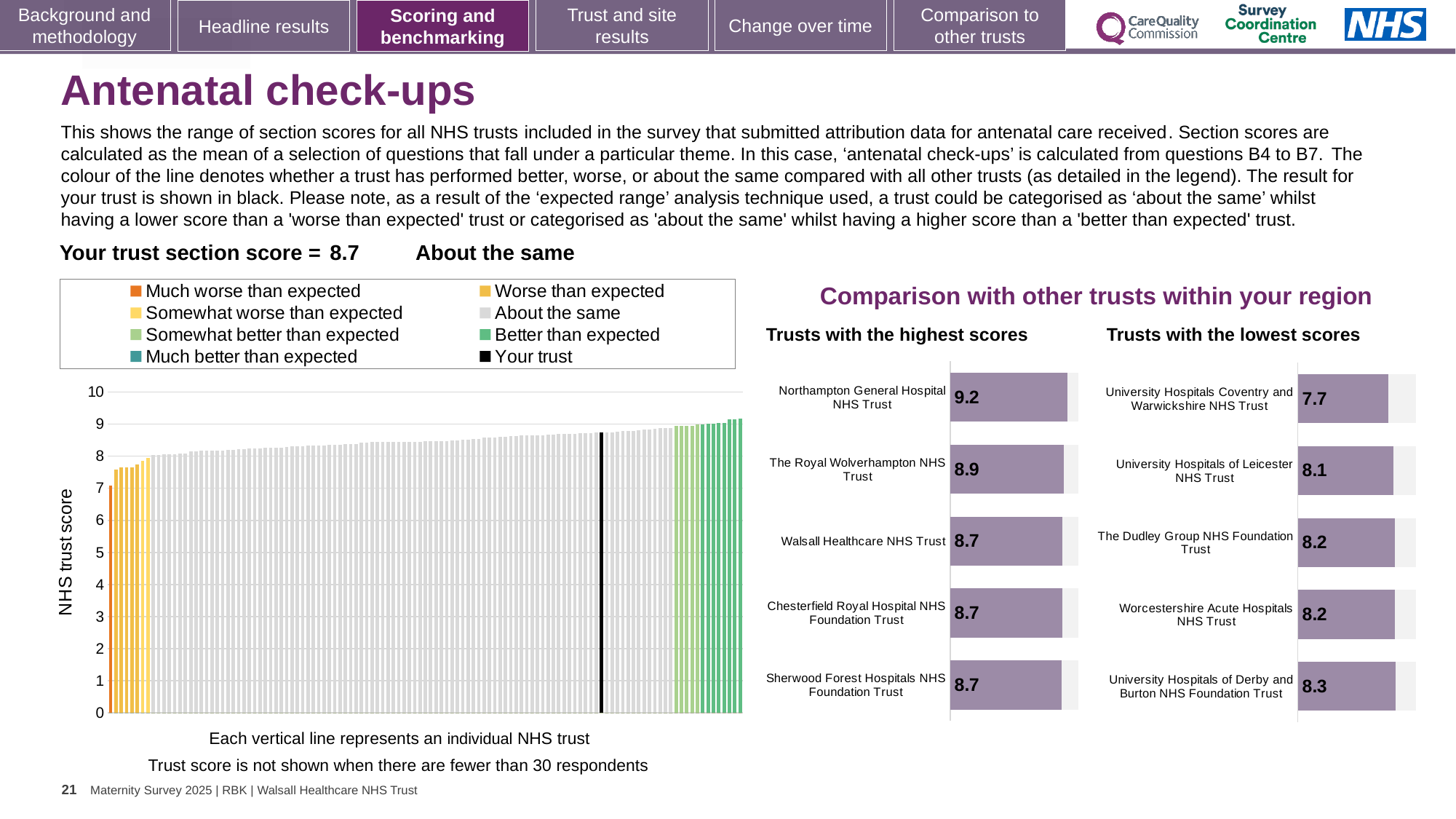
In the 'Trusts with the highest scores' chart, how many trusts are shown? 5 How many entries does the legend of the 'NHS trust score' chart on the left list? 8 In the 'NHS trust score' chart on the left, is the value of the leftmost (orange) bar greater or less than 8? less In the 'Trusts with the lowest scores' chart, what is the score for The Dudley Group NHS Foundation Trust? 8.2 In the 'Trusts with the lowest scores' chart, which trust has the lowest score? University Hospitals Coventry and Warwickshire NHS Trust In the 'NHS trust score' chart on the left, do the bar values rise or fall from left to right? Rise In the 'Trusts with the highest scores' chart, what is the score for Northampton General Hospital NHS Trust? 9.2 What kind of chart is the 'NHS trust score' chart on the left of the slide? Bar chart In the 'Trusts with the highest scores' chart, which trust has the highest score? Northampton General Hospital NHS Trust In the 'Trusts with the lowest scores' chart, which has the larger score: University Hospitals of Leicester NHS Trust or University Hospitals of Derby and Burton NHS Foundation Trust? University Hospitals of Derby and Burton NHS Foundation Trust In the 'Trusts with the highest scores' chart, what is the difference between the scores of Northampton General Hospital NHS Trust and The Royal Wolverhampton NHS Trust? 0.3 In the 'Trusts with the lowest scores' chart, what is the score for University Hospitals Coventry and Warwickshire NHS Trust? 7.7